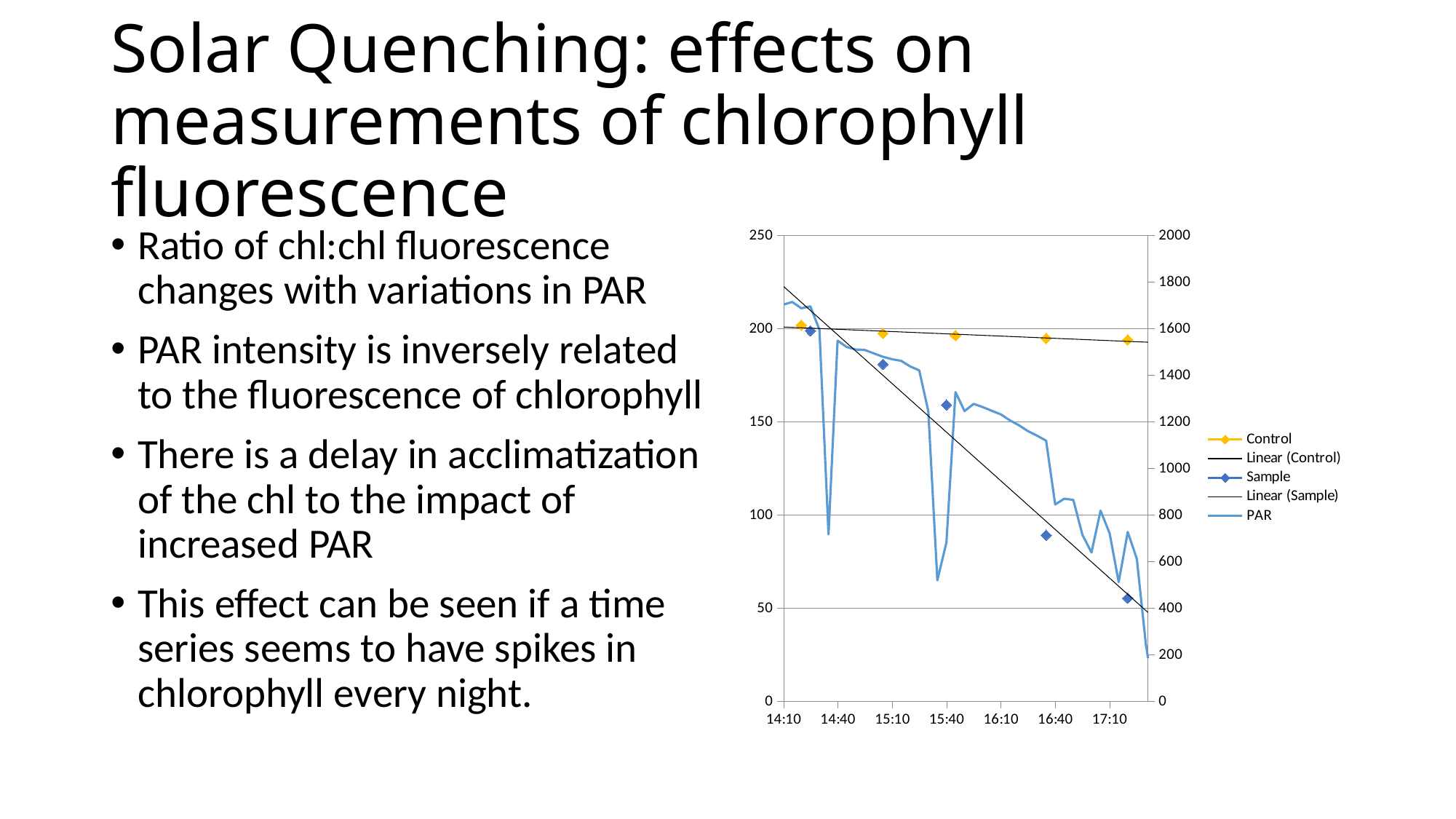
Is the Sample point near 16:35 greater or less than 100 on the left axis? less Is the first Sample point (near 14:25) greater or less than 150 on the left axis? greater At the last time point (after 17:10), which is larger, the Control value or the Sample value? Control What is the maximum value shown on the right-hand vertical axis? 2000 How many series does the legend list? 5 Which series is plotted as a continuous blue line without markers? PAR Is the last Sample point (after 17:10) greater or less than 100 on the left axis? less Do the Sample values rise or fall over time along the x axis? fall How many Control data points are plotted? 5 What kind of chart is shown on the slide? line chart